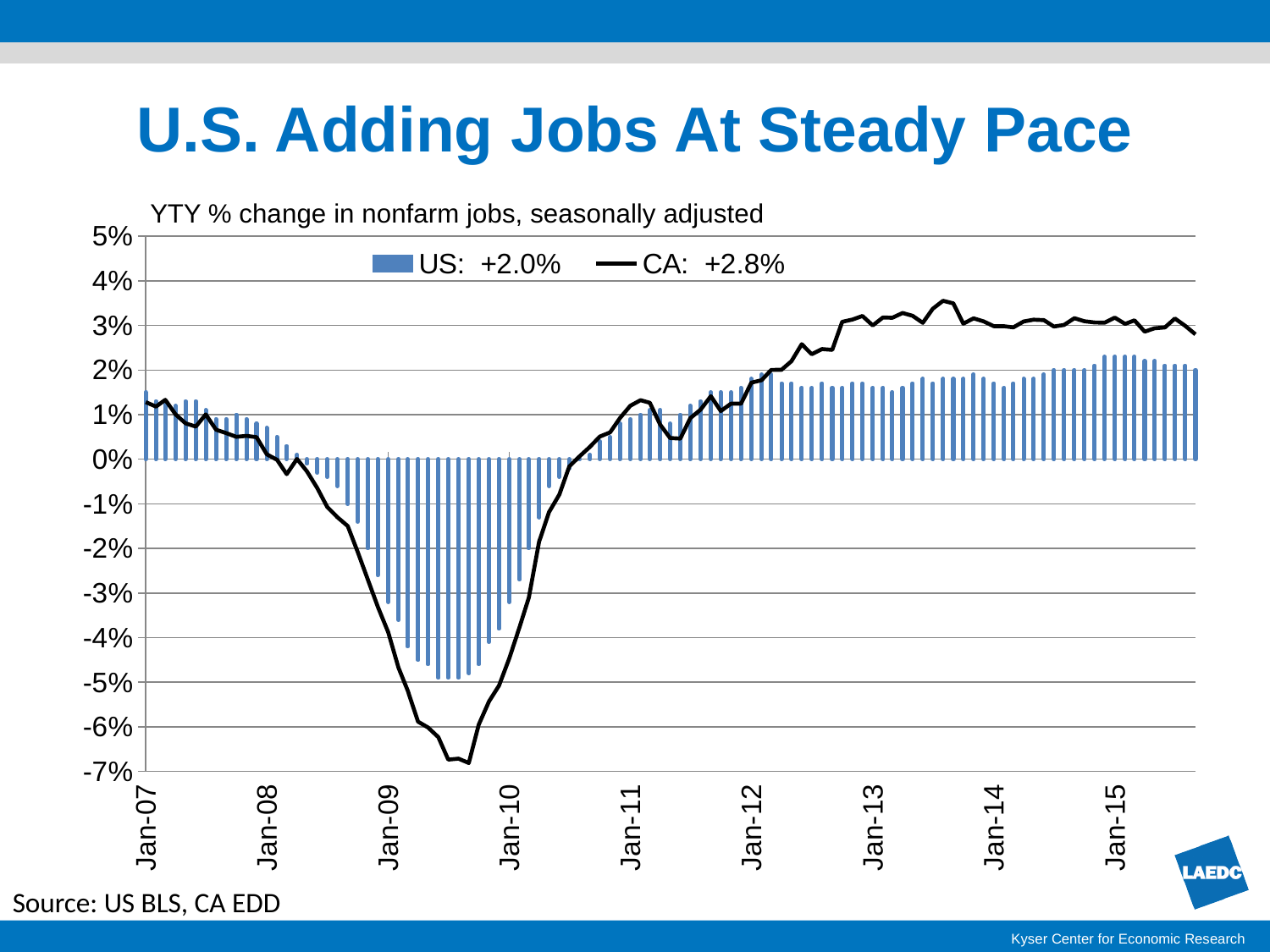
What value is shown for US in the chart legend? +2.0% Is the lowest CA value on the chart greater or less than -6%? less Do the US values rise or fall between Jan-09 and Jan-11? rise How many series does the chart legend list? 2 Which series is drawn as a line rather than bars? CA How many year labels are shown on the x axis? 9 What kind of chart is this? Combination bar and line chart Is the CA value at Jan-13 greater or less than 2%? greater What value is shown for CA in the chart legend? +2.8% At Jan-13, which series has the higher value, US or CA? CA Is the US value at Jan-09 greater or less than 0%? less What is the subtitle printed above the chart? YTY % change in nonfarm jobs, seasonally adjusted